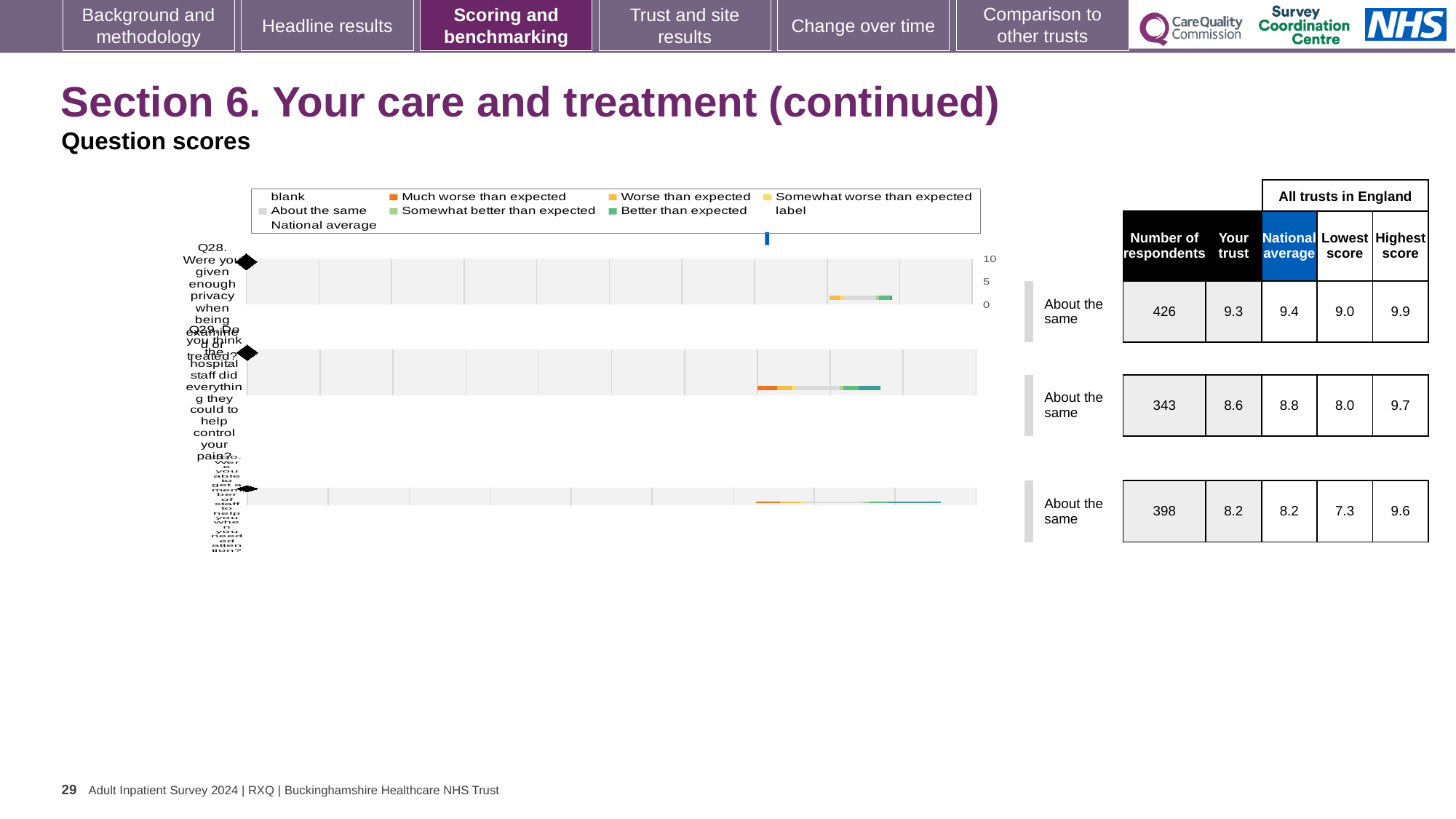
Which question has the lowest 'Lowest score' across all trusts in England? Q30 What is the 'Your trust' score for Q28 (privacy when being examined or treated)? 9.3 How many respondents answered Q30? 398 What kind of chart is used to show the question scores? Bar chart For Q28, which is larger: the 'Your trust' score or the national average? National average What is the national average score for Q29 (staff did everything to help control pain)? 8.8 How many questions are plotted on the slide? 3 Is the 'Your trust' score for Q30 greater or less than 5? greater Which question has the highest 'Your trust' score? Q28 What benchmark category is shown for all three questions? About the same What colour represents 'Much worse than expected' in the legend? Orange What is the difference between the highest score and the lowest score for Q28? 0.9